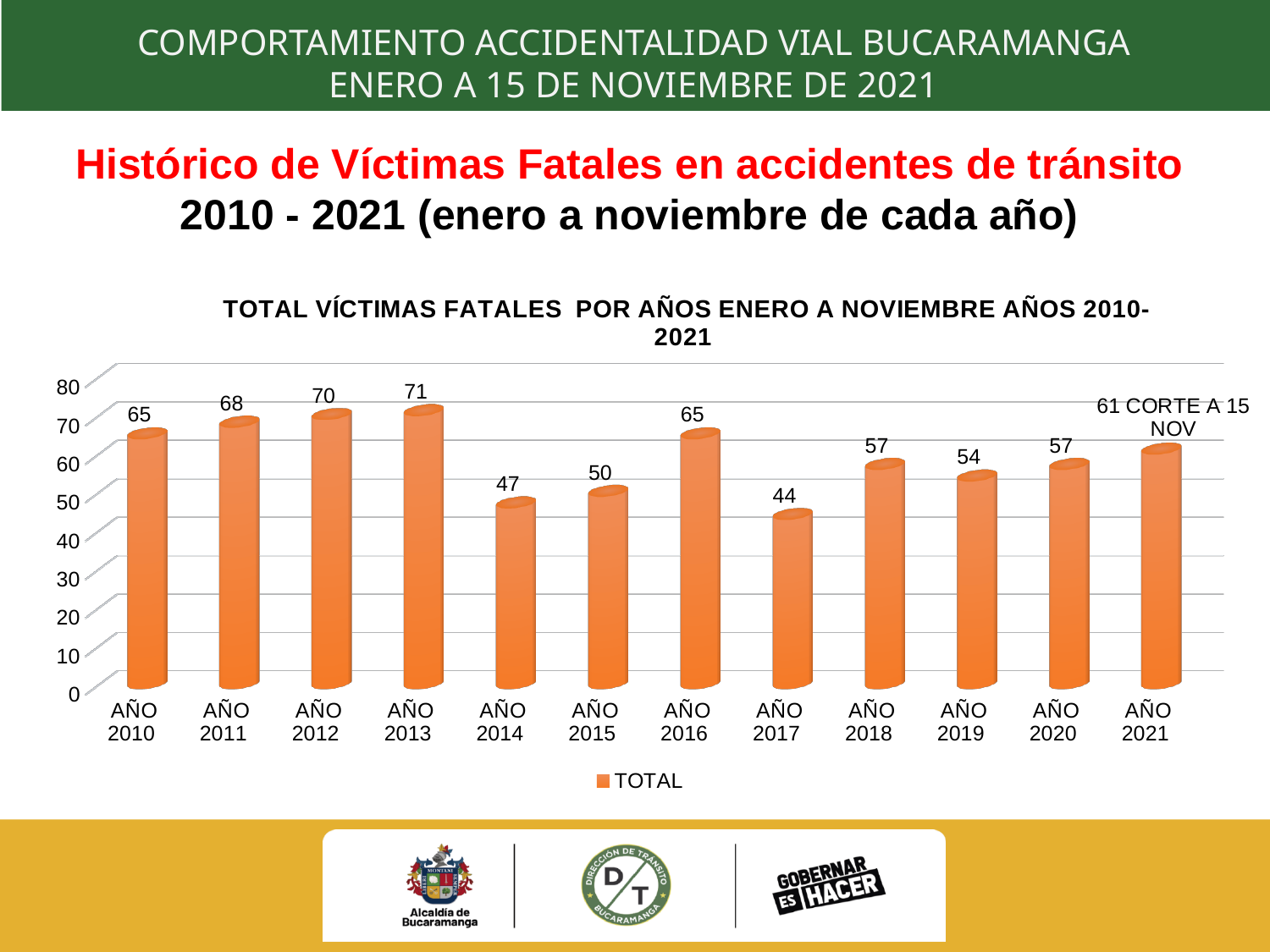
What is the legend entry for the series? TOTAL What is the value for AÑO 2021? 61 Which year has the highest value? AÑO 2013 What kind of chart is shown? bar chart Which is larger, the value for AÑO 2014 or the value for AÑO 2015? AÑO 2015 How many years are shown on the x axis? 12 Is the value for AÑO 2016 greater or less than 60? greater How many series does the legend list? 1 What is the value for AÑO 2013? 71 Which year has the lowest value? AÑO 2017 What is the difference between the values for AÑO 2013 and AÑO 2017? 27 What is the value for AÑO 2017? 44